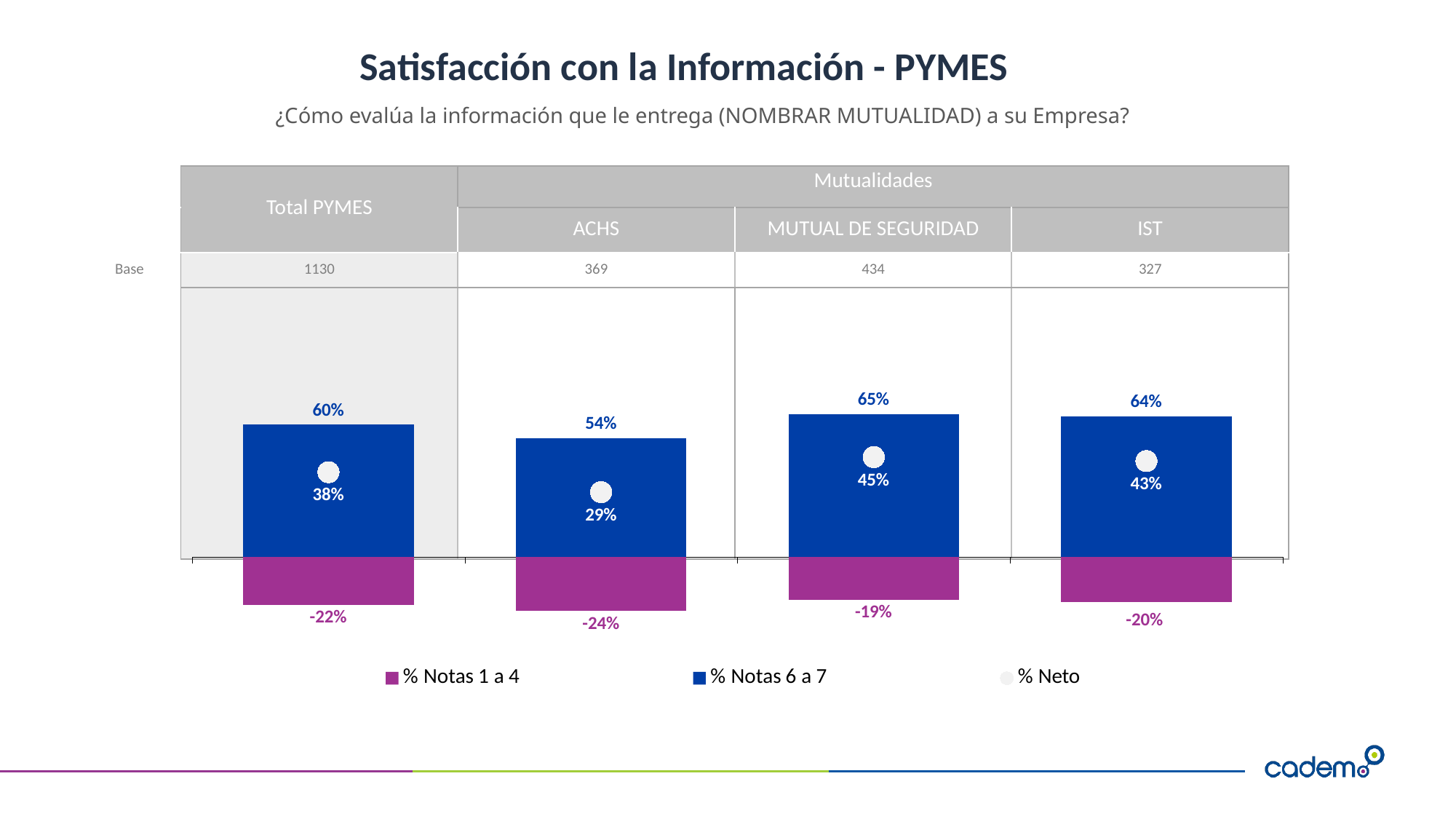
What is the % Notas 1 a 4 value for ACHS? -24% What is the % Neto value for Total PYMES? 38% Which category has the highest % Notas 6 a 7 value? MUTUAL DE SEGURIDAD What is the % Neto value for IST? 43% Which has a larger % Neto value, Total PYMES or IST? IST What kind of chart is shown on the slide? Bar chart What is the difference between the % Notas 6 a 7 values for MUTUAL DE SEGURIDAD and ACHS? 11% How many categories are shown on the x axis of the chart? 4 What is the % Notas 6 a 7 value for MUTUAL DE SEGURIDAD? 65% Which category has the lowest % Neto value? ACHS What is the base (sample size) shown for ACHS? 369 How many series does the legend list? 3